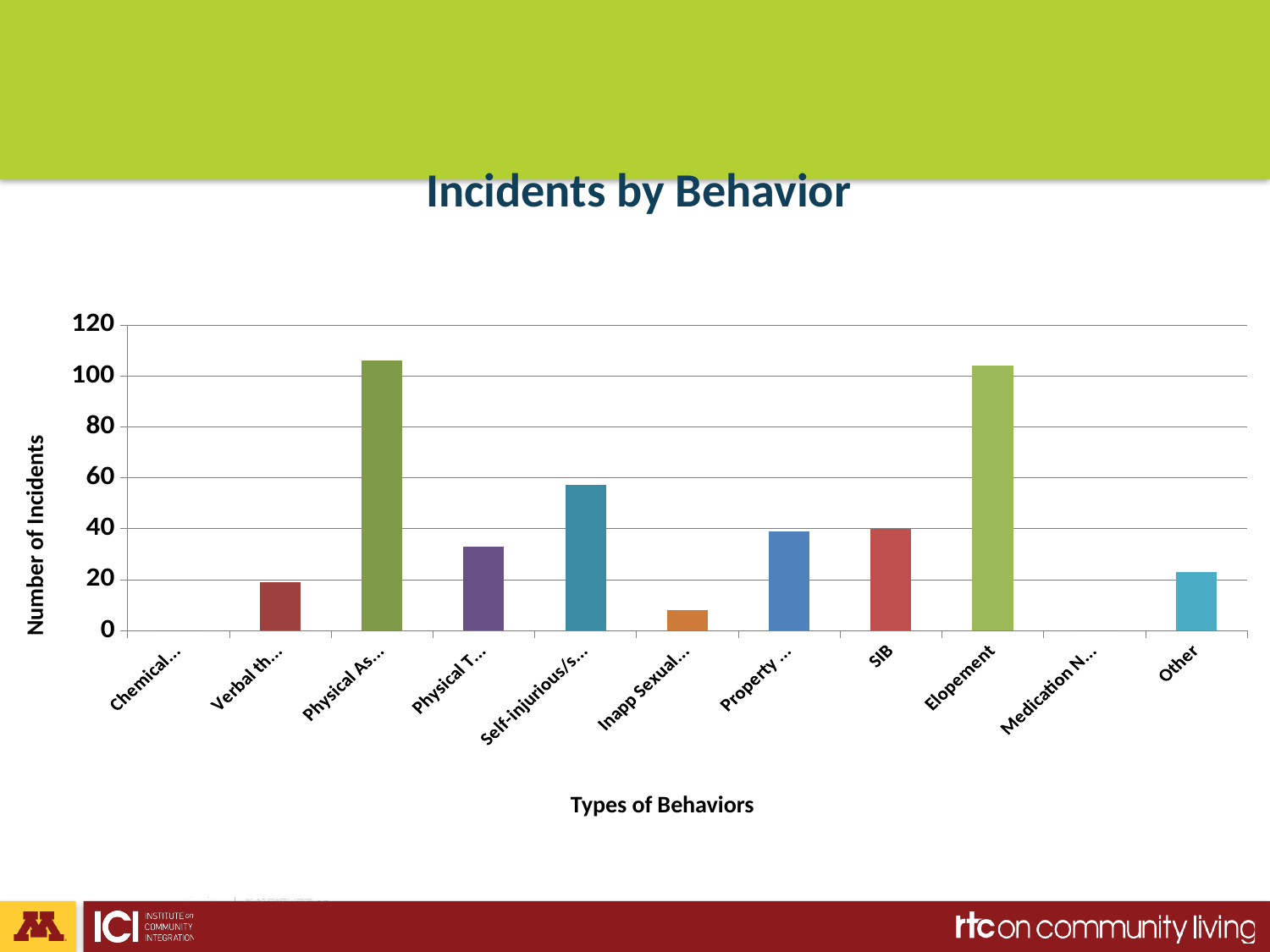
Is the value for Elopement greater or less than 120? less What kind of chart is shown on the slide? bar chart Which has more incidents, Elopement or Other? Elopement Is the value for Other greater or less than 40? less Is the value for Elopement greater or less than 80? greater What is the label on the vertical axis of the chart? Number of Incidents Which has more incidents, SIB or Other? SIB How many behavior categories are shown on the x axis of the chart? 11 What is the title of the chart? Incidents by Behavior Which has more incidents, Elopement or SIB? Elopement